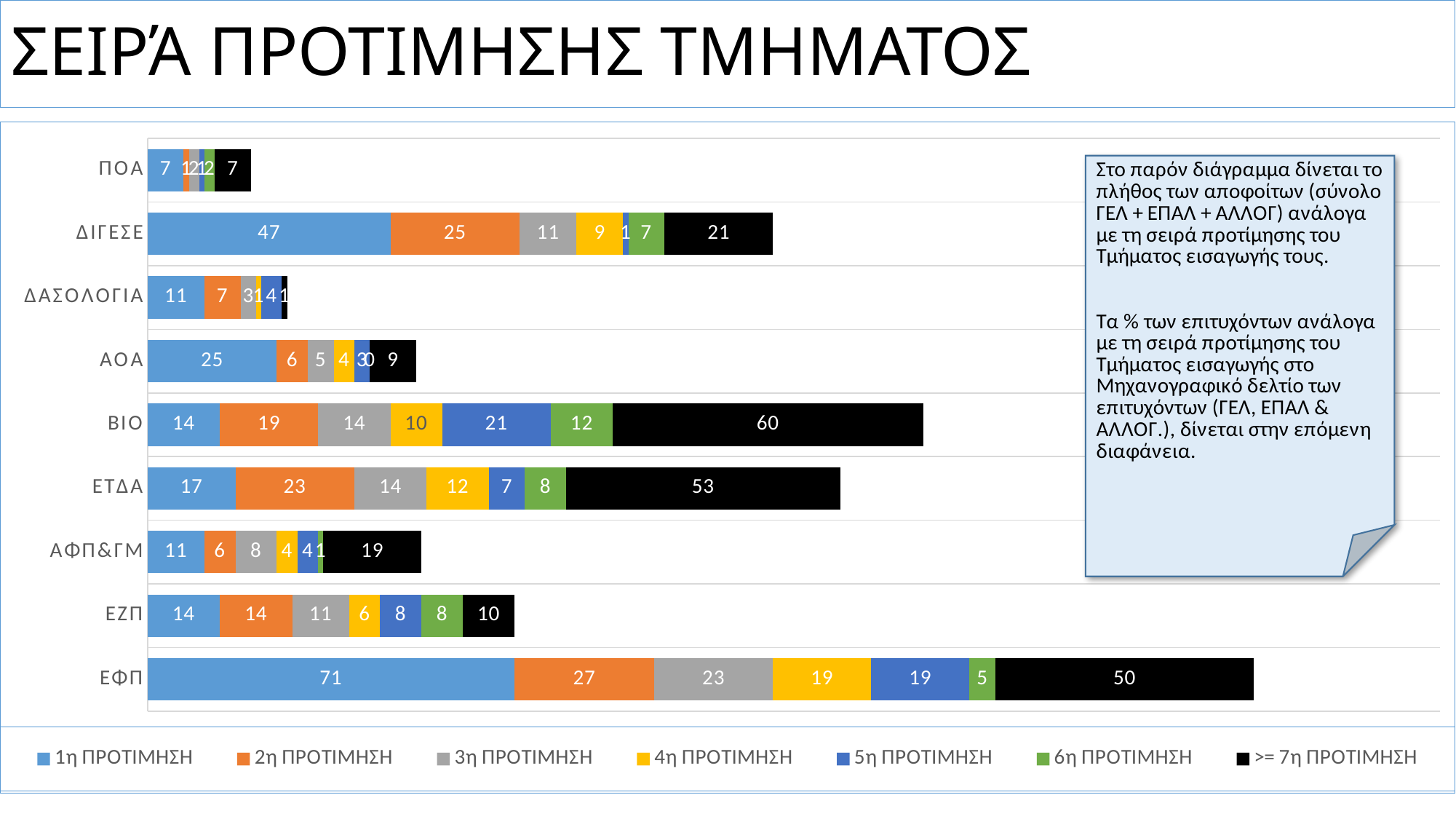
Which category has the highest value for 1η ΠΡΟΤΙΜΗΣΗ? ΕΦΠ What is the last entry listed in the chart legend? >= 7η ΠΡΟΤΙΜΗΣΗ What is the value of 2η ΠΡΟΤΙΜΗΣΗ for ΔΙΓΕΣΕ? 25 What is the difference between the 2η ΠΡΟΤΙΜΗΣΗ and 3η ΠΡΟΤΙΜΗΣΗ values for ΕΦΠ? 4 What type of chart is shown on the slide? stacked bar chart How many categories (departments) are shown on the y axis of the chart? 9 What is the total of the stacked bar for ΕΖΠ? 71 What is the value of >= 7η ΠΡΟΤΙΜΗΣΗ for ΒΙΟ? 60 Which category has the longest total stacked bar? ΕΦΠ Which is larger, the >= 7η ΠΡΟΤΙΜΗΣΗ value for ΒΙΟ or for ΕΤΔΑ? ΒΙΟ What is the value of 1η ΠΡΟΤΙΜΗΣΗ for ΕΦΠ? 71 How many series does the legend list? 7